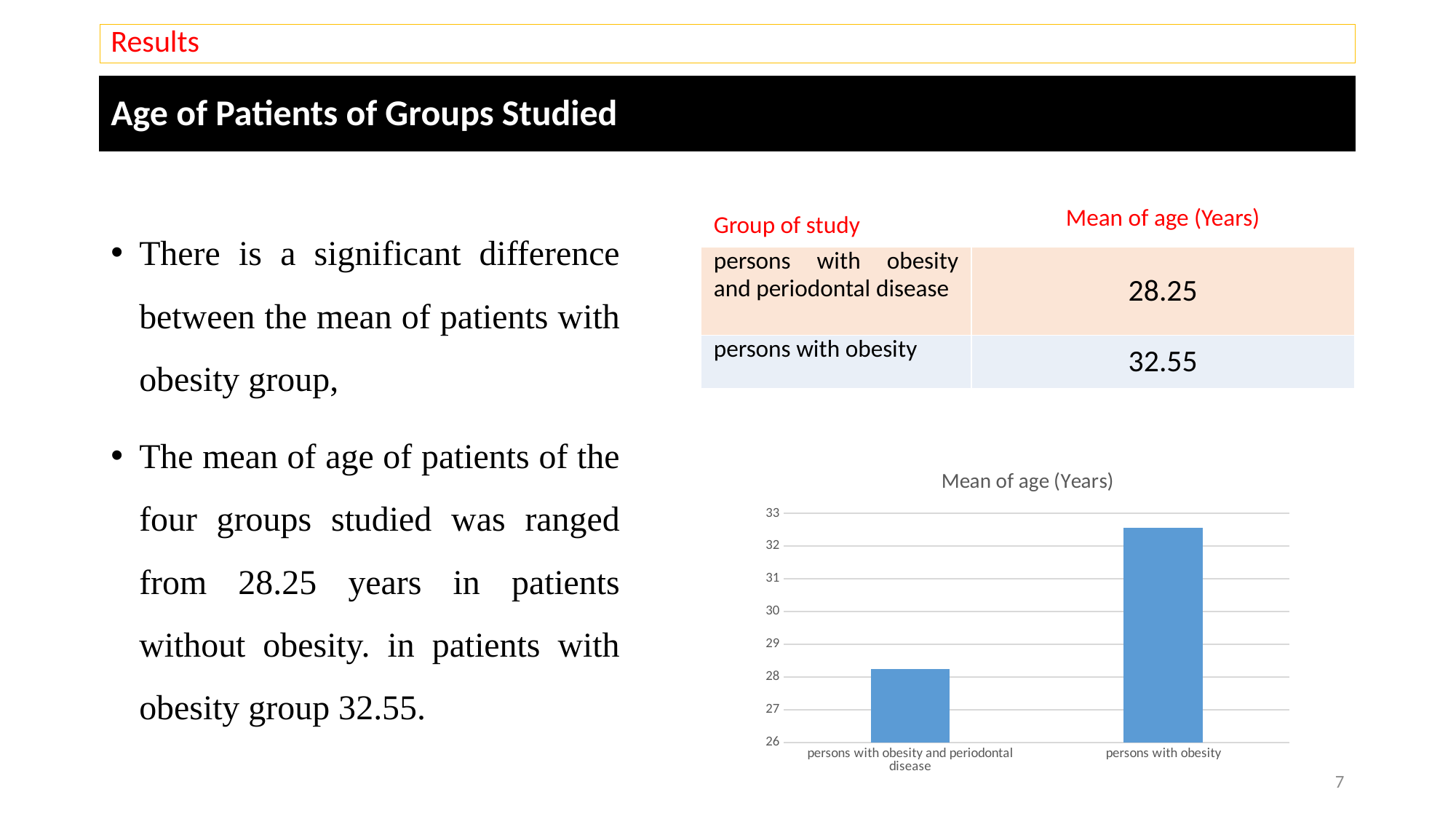
What type of chart is shown on the slide? bar chart What is the title of the chart? Mean of age (Years) What is the mean age for persons with obesity? 32.55 Is the mean age for persons with obesity greater or less than 32? greater Which group has the higher mean age in the chart? persons with obesity What is the lowest value shown on the chart's vertical axis? 26 How many bars does the chart show? 2 Is the bar for persons with obesity taller or shorter than the bar for persons with obesity and periodontal disease? taller Which group has the lower mean age in the chart? persons with obesity and periodontal disease What is the mean age for persons with obesity and periodontal disease? 28.25 Is the mean age for persons with obesity and periodontal disease greater or less than 29? less What is the difference in mean age between persons with obesity and persons with obesity and periodontal disease? 4.30